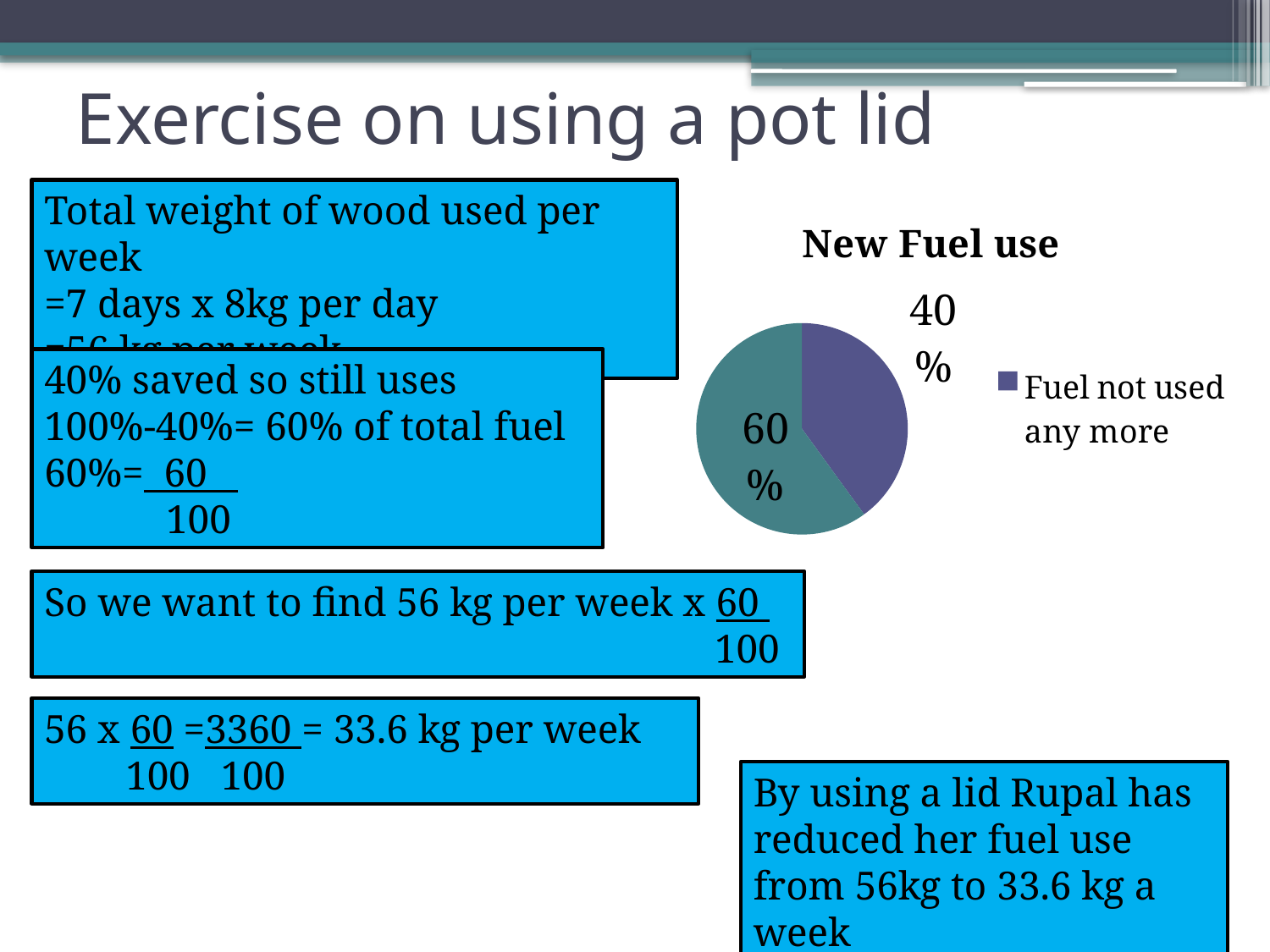
What is the title of the chart? New Fuel use How many entries does the chart's legend list? 1 Which slice is larger: the 'Fuel not used any more' slice or the other slice? the other slice What legend entry is shown for the purple slice? Fuel not used any more What kind of chart is shown on the slide? pie chart What is the difference between the two slices of the pie chart? 20% What percentage is shown for the 'Fuel not used any more' slice? 40% What is the value of the largest slice in the pie chart? 60% What percentage is shown on the larger slice of the pie chart? 60% What is the value of the smallest slice in the pie chart? 40% Is the 'Fuel not used any more' slice greater or less than half of the pie? less How many slices does the pie chart have? 2